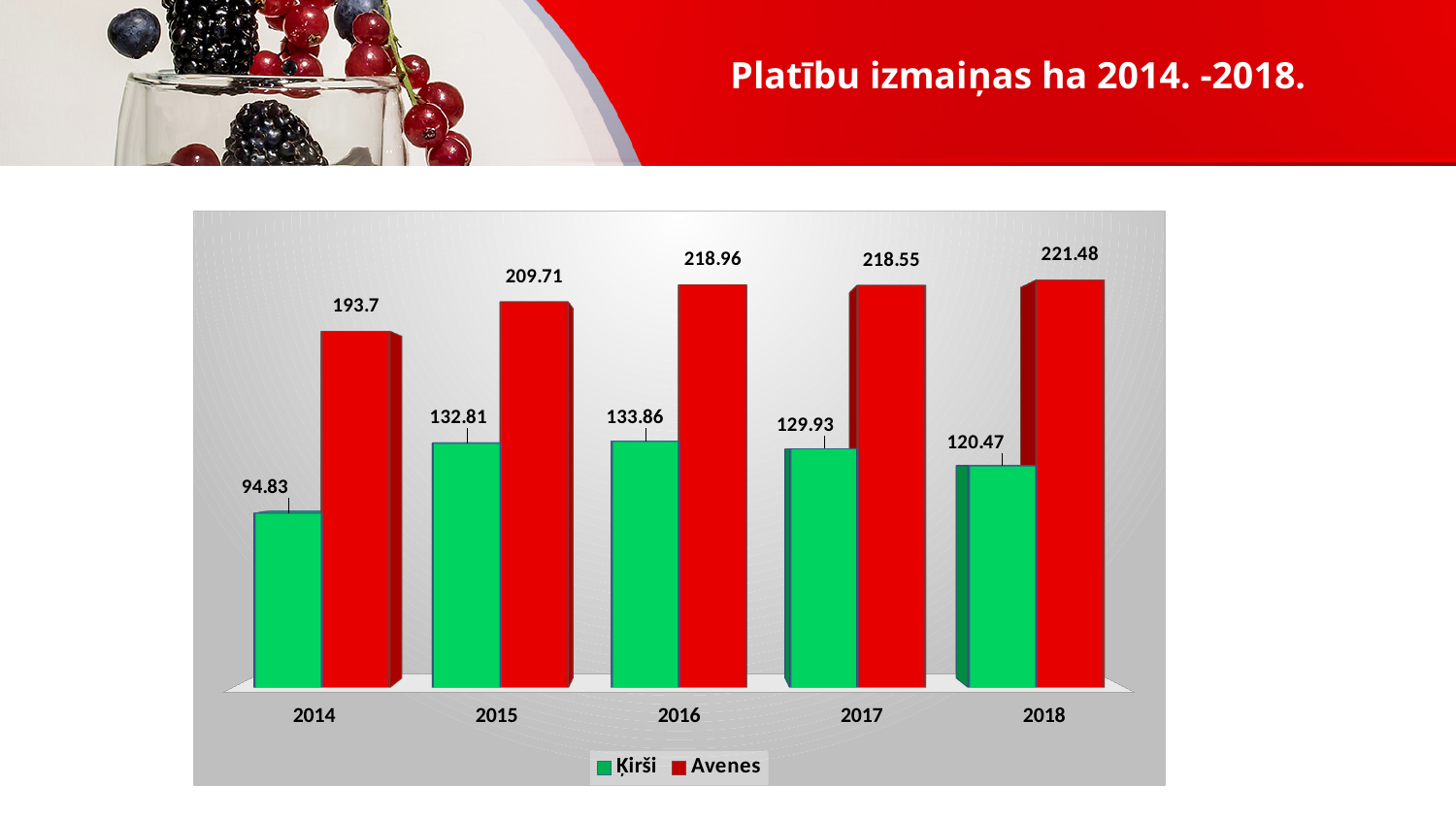
What kind of chart is shown on the slide? Bar chart In which year is the Avenes value highest? 2018 In which year is the Ķirši value highest? 2016 What is the value for Avenes in 2018? 221.48 In which year is the Ķirši value lowest? 2014 What is the value for Avenes in 2015? 209.71 How many series does the legend list? 2 By how much did the Ķirši value increase from 2014 to 2015? 37.98 How many years are shown on the x axis? 5 Which is larger, the Avenes value in 2016 or in 2017? 2016 What is the difference between the Avenes and Ķirši values in 2018? 101.01 What is the value for Ķirši in 2014? 94.83